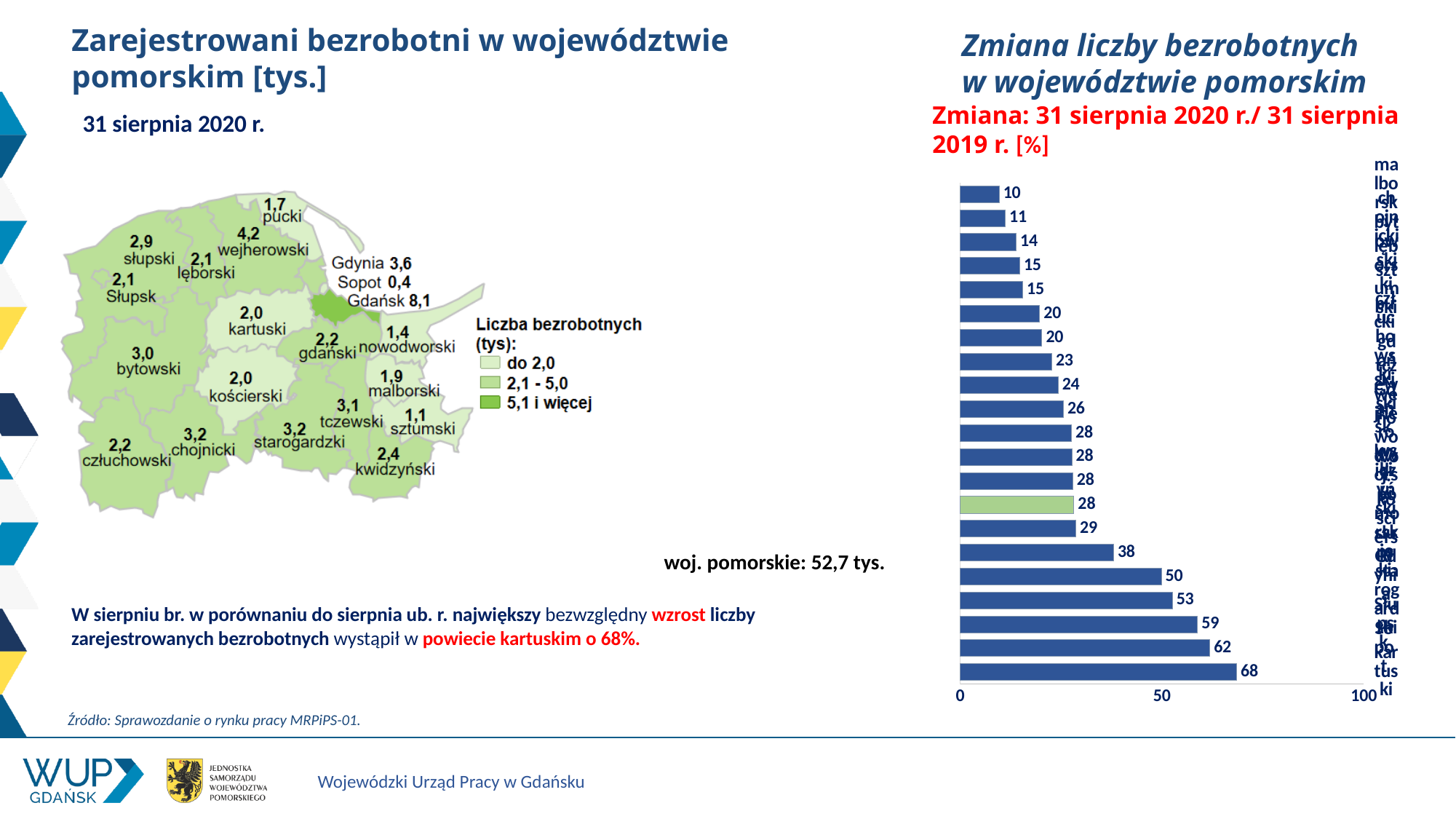
In the bar chart on the right, how many bars have a value greater than 50? 4 In the bar chart on the right, how many bars have the value 28? 4 What kind of chart is shown on the right side of the slide under the title 'Zmiana liczby bezrobotnych w województwie pomorskim'? bar chart In the bar chart on the right, what is the difference between the highest value (68) and the lowest value (10)? 58 On the map on the left, what is the number of registered unemployed (tys.) shown for Gdańsk? 8,1 In the bar chart on the right, what is the lowest value shown? 10 In the bar chart on the right, what is the value for the kartuski bar (the bottom bar)? 68 In the bar chart on the right, is the value of the bottom bar (68) greater or less than 50? greater In the bar chart on the right, what is the highest value shown? 68 In the bar chart on the right, what is the maximum value shown on the horizontal axis? 100 How many bars are plotted in the bar chart on the right? 21 In the bar chart on the right, what value is shown on the single green bar? 28